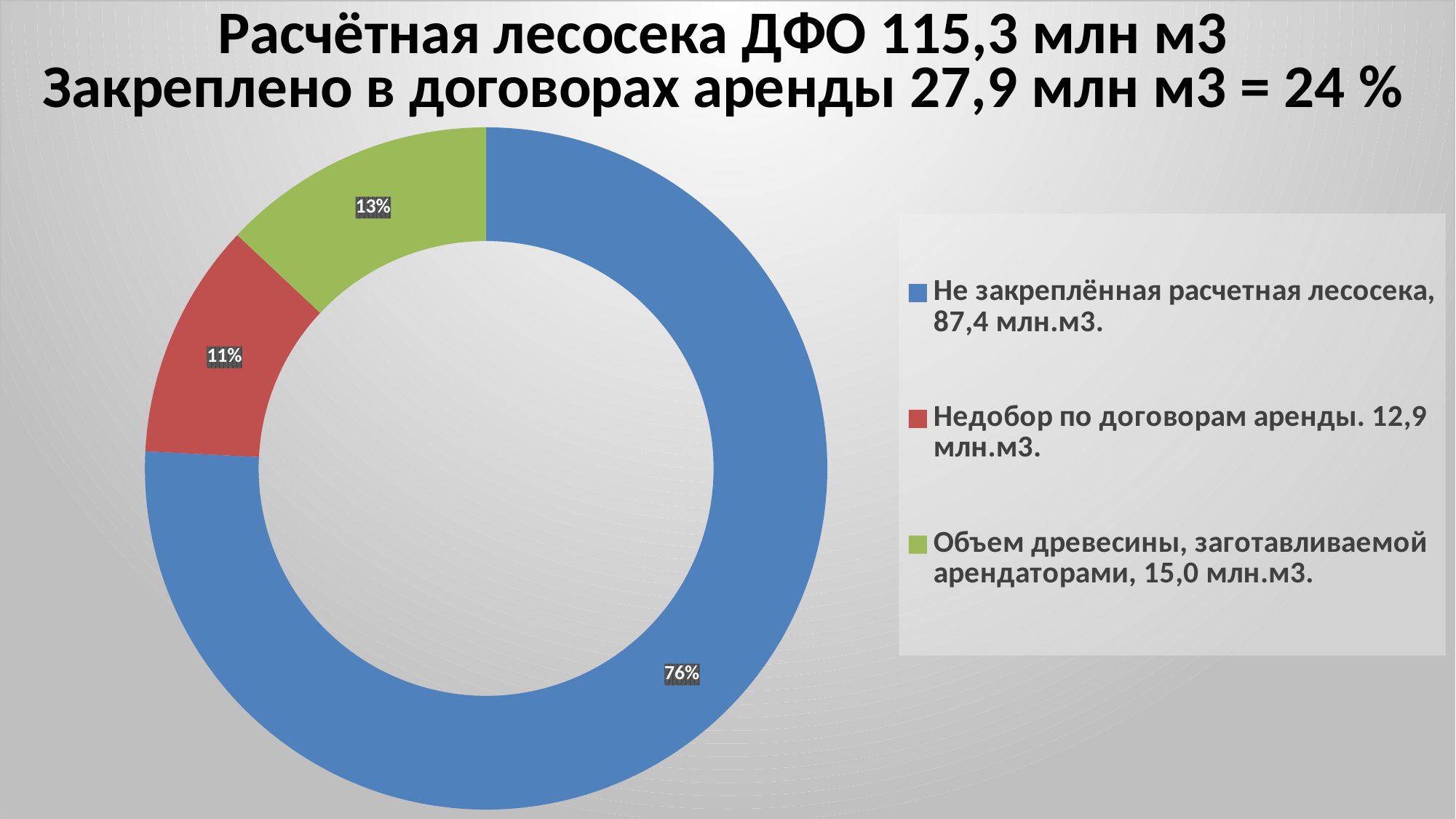
Which slice is larger: "Недобор по договорам аренды" or "Объем древесины, заготавливаемой арендаторами"? Объем древесины, заготавливаемой арендаторами What percentage is shown on the green slice ("Объем древесины, заготавливаемой арендаторами")? 13% How many slices does the chart have? 3 What share of the doughnut chart is labelled for "Не закреплённая расчетная лесосека"? 76% Which category has the smallest slice of the chart? Недобор по договорам аренды What is the difference in percentage points between the blue slice (76%) and the red slice (11%)? 65 percentage points According to the legend, what volume in млн.м3 corresponds to "Недобор по договорам аренды"? 12,9 млн.м3 According to the slide title, what is the total расчётная лесосека ДФО? 115,3 млн м3 What kind of chart is shown on the slide? Doughnut (pie) chart What percentage is shown on the red slice ("Недобор по договорам аренды")? 11% Which category has the largest slice of the chart? Не закреплённая расчетная лесосека What colour is the slice for "Объем древесины, заготавливаемой арендаторами"? Green